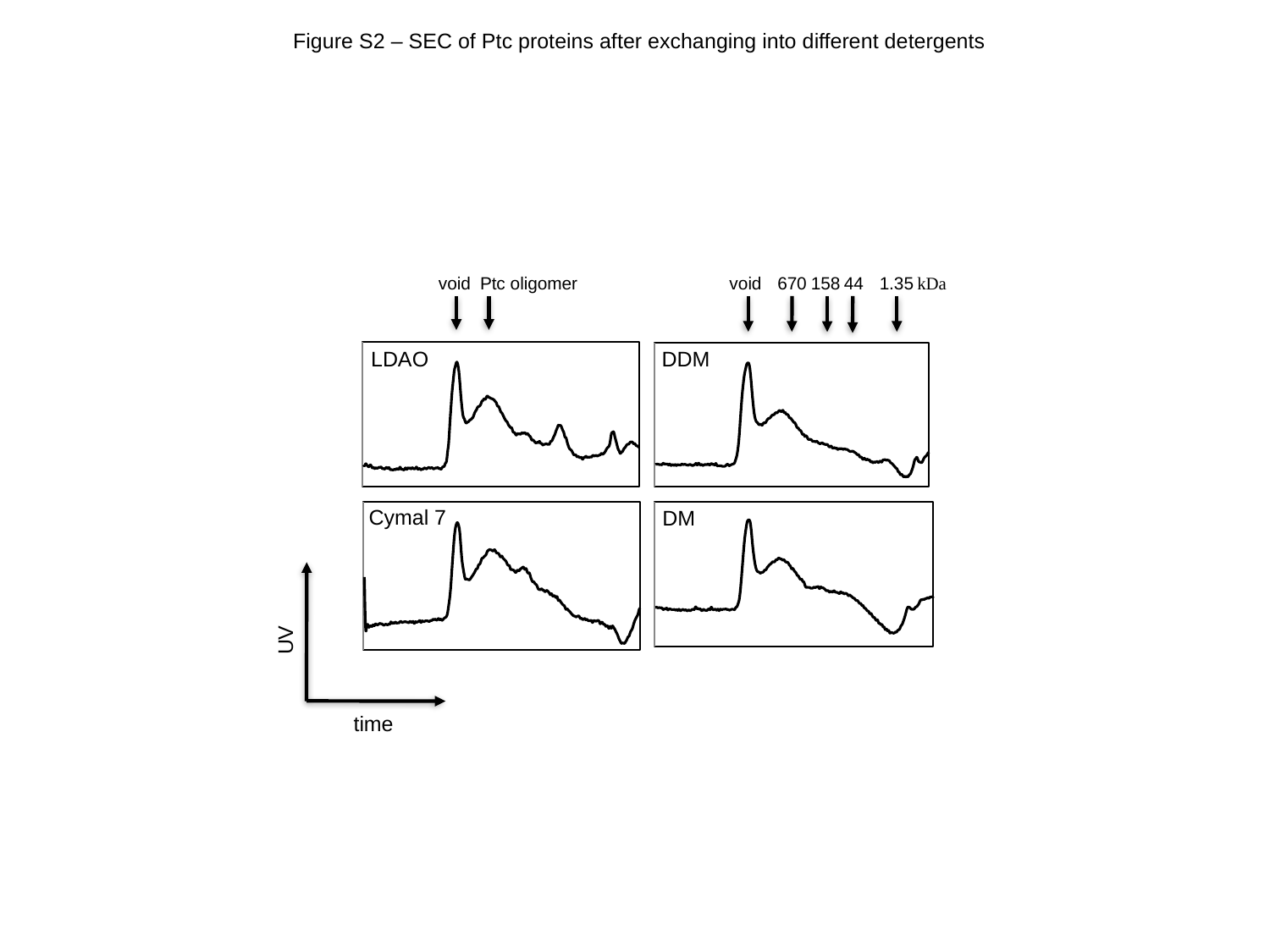
How many molecular weight standards (excluding void) are marked with arrows above the right-hand panels? 4 In the LDAO panel, which peak is taller: the void peak or the Ptc oligomer peak? void In the DDM panel, which peak is taller: the void peak or the peak near the 670 kDa marker? void How many chromatogram panels are shown on the slide? 4 Which detergent is shown in the bottom-right panel? DM In the DM panel, which peak is taller: the void peak or the peak near the 670 kDa marker? void What is the label on the vertical axis of the charts? UV What kind of chart is shown in each of the four panels? line chart